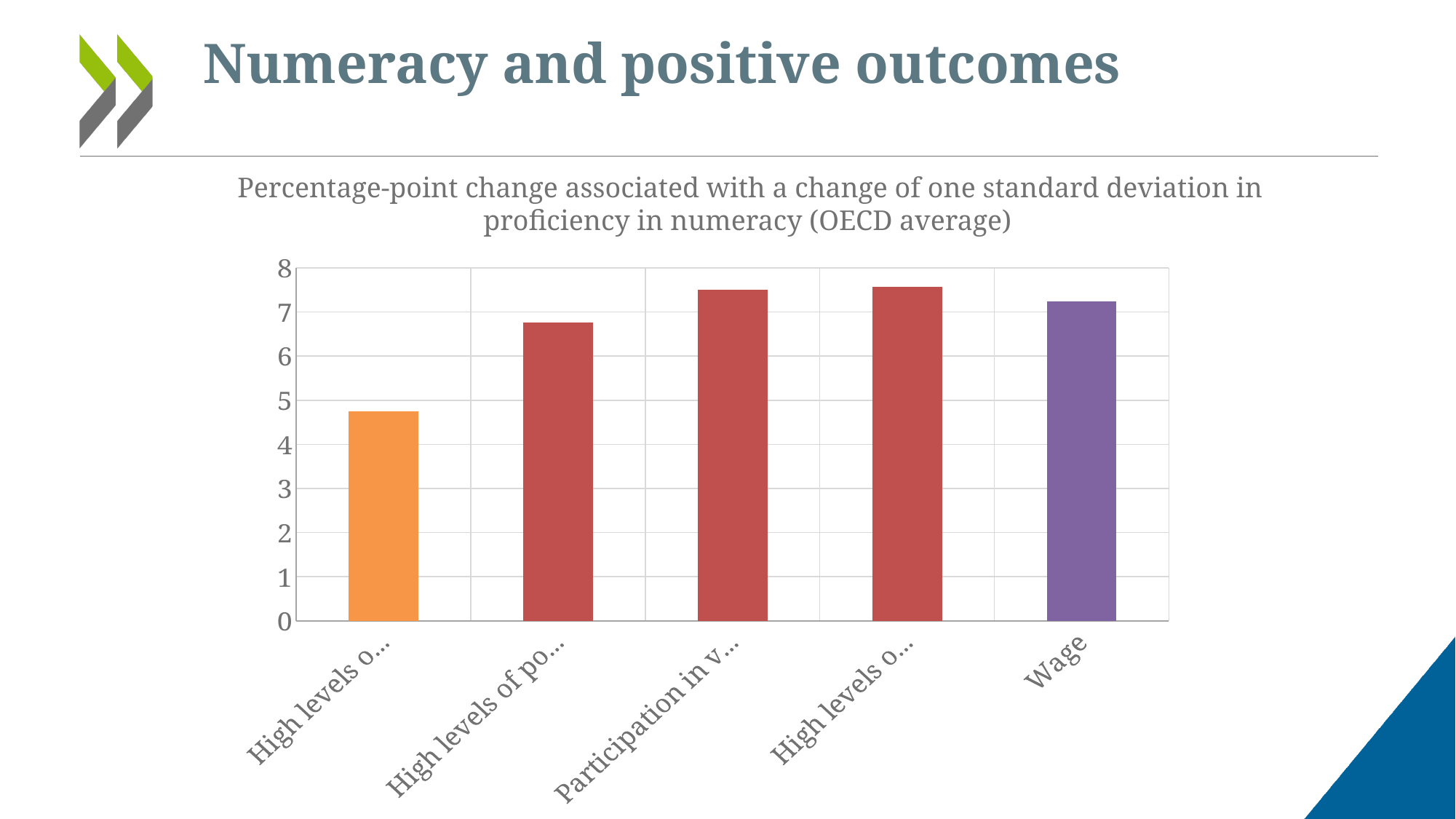
What colour is the Wage bar? purple What is the title of the chart? Percentage-point change associated with a change of one standard deviation in proficiency in numeracy (OECD average) Is the value for Wage greater or less than 7? greater Is the value of the first (orange) bar from the left greater or less than 5? less Which is larger: the value for Wage or the value of the second bar from the left? Wage What kind of chart is shown on the slide? bar chart Is the value for Wage greater or less than 8? less Which bar has the lowest value: the first (orange) bar or the Wage bar? the first (orange) bar Which bar in the chart has the lowest value? the first (orange) bar from the left How many bars (categories) does the chart show? 5